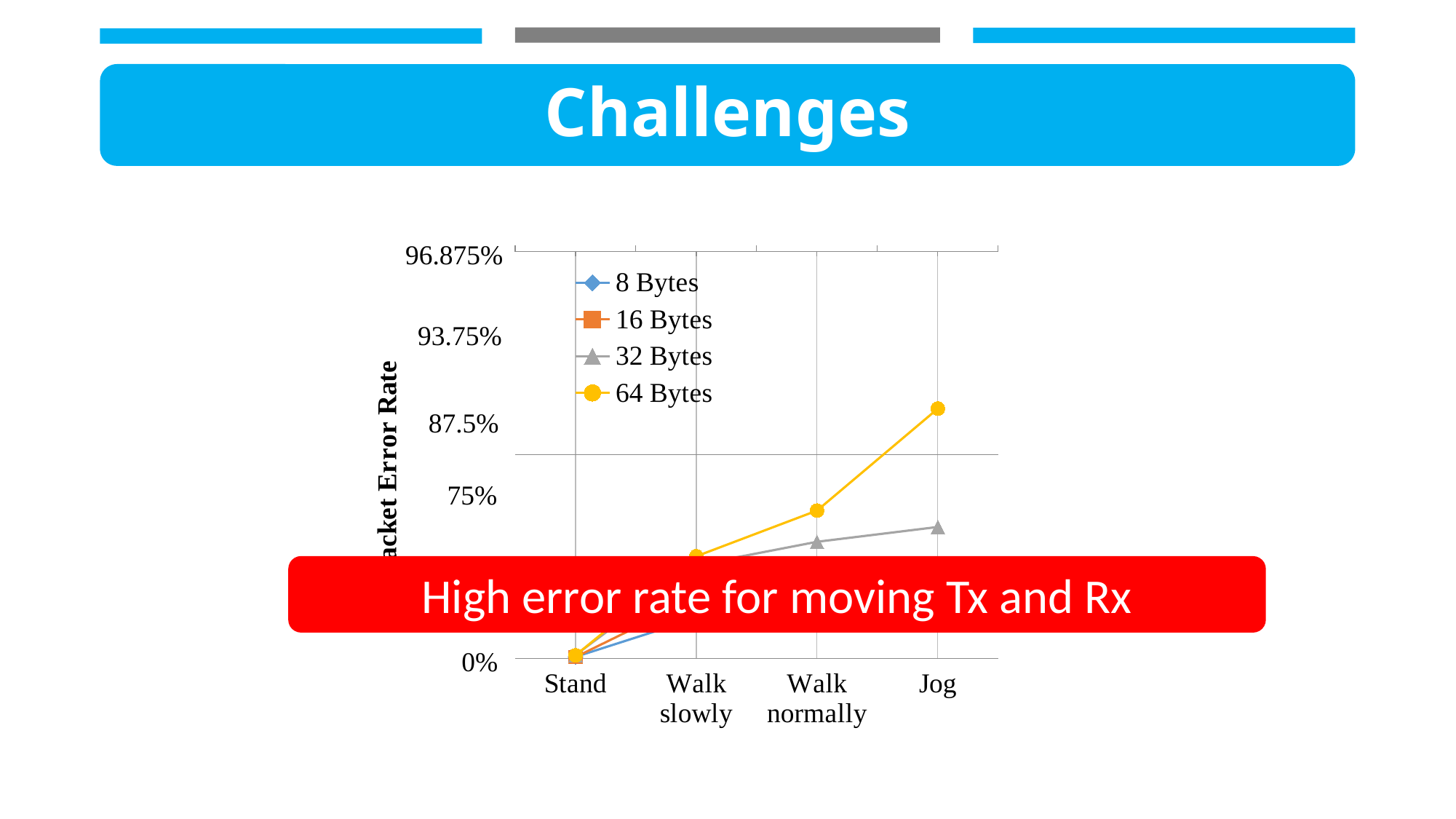
How many categories are shown on the x axis? 4 Does the 64 Bytes series rise or fall from Stand to Jog? rise What is the highest tick label shown on the y axis? 96.875% What type of chart is shown on the slide? line chart Which series is drawn with triangle markers? 32 Bytes Is the value for 64 Bytes at Jog greater or less than 87.5%? greater Which series has the highest value at Jog? 64 Bytes At Jog, which series has the larger value: 64 Bytes or 32 Bytes? 64 Bytes How many series does the legend list? 4